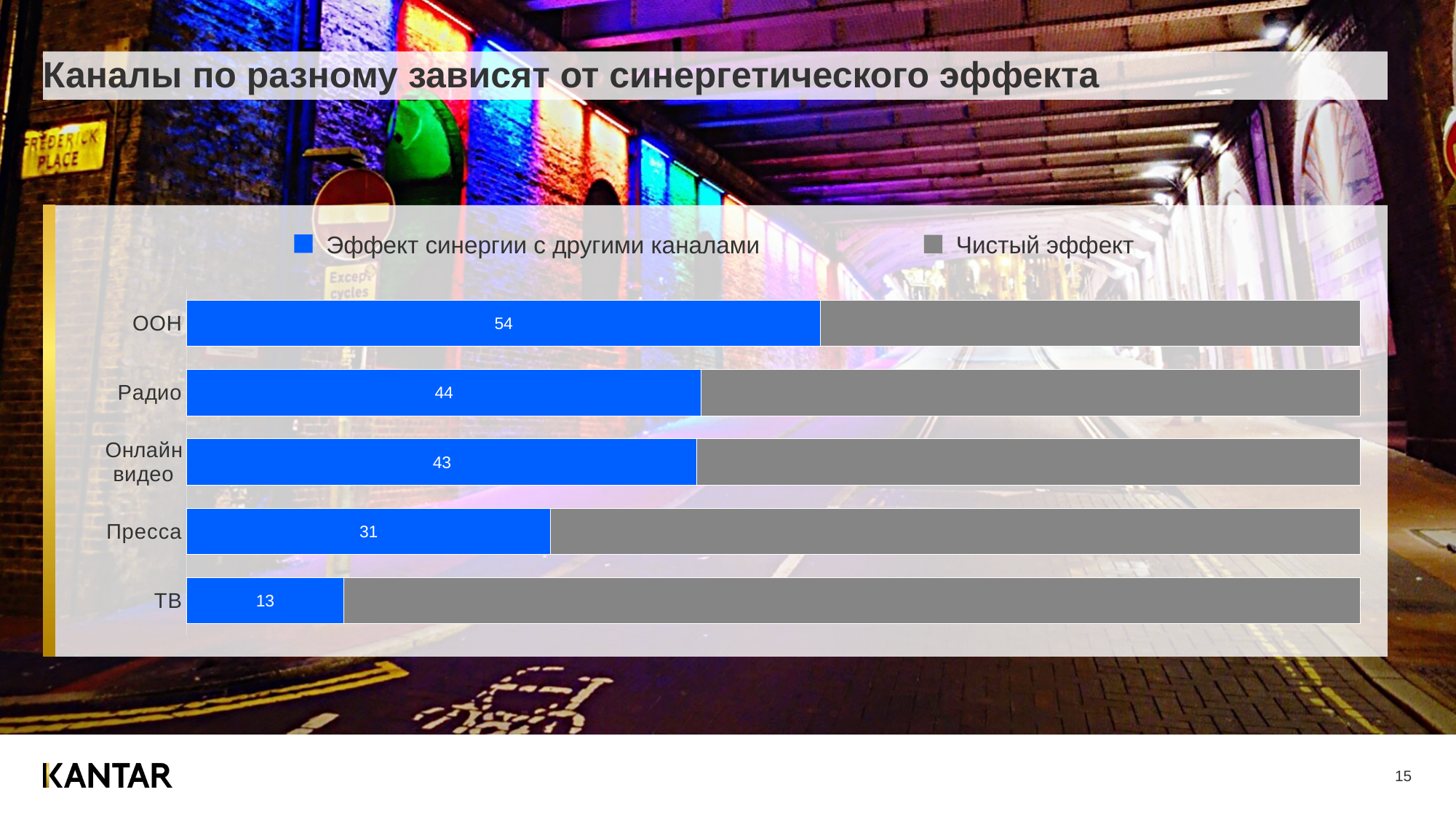
What is the value of "Эффект синергии с другими каналами" for Онлайн видео? 43 What is the value of "Эффект синергии с другими каналами" for ТВ? 13 What kind of chart is shown on the slide? Stacked bar chart What is the difference between the "Эффект синергии с другими каналами" values for Радио and Пресса? 13 What is the value of "Эффект синергии с другими каналами" for ООН? 54 What is the value of "Эффект синергии с другими каналами" for Радио? 44 How many series does the legend list? 2 Which has a larger "Эффект синергии с другими каналами" value, Пресса or ТВ? Пресса Which channel has the highest value for "Эффект синергии с другими каналами"? ООН What is the difference between the "Эффект синергии с другими каналами" values for ООН and ТВ? 41 How many channels are shown in the chart? 5 Which channel has the lowest value for "Эффект синергии с другими каналами"? ТВ